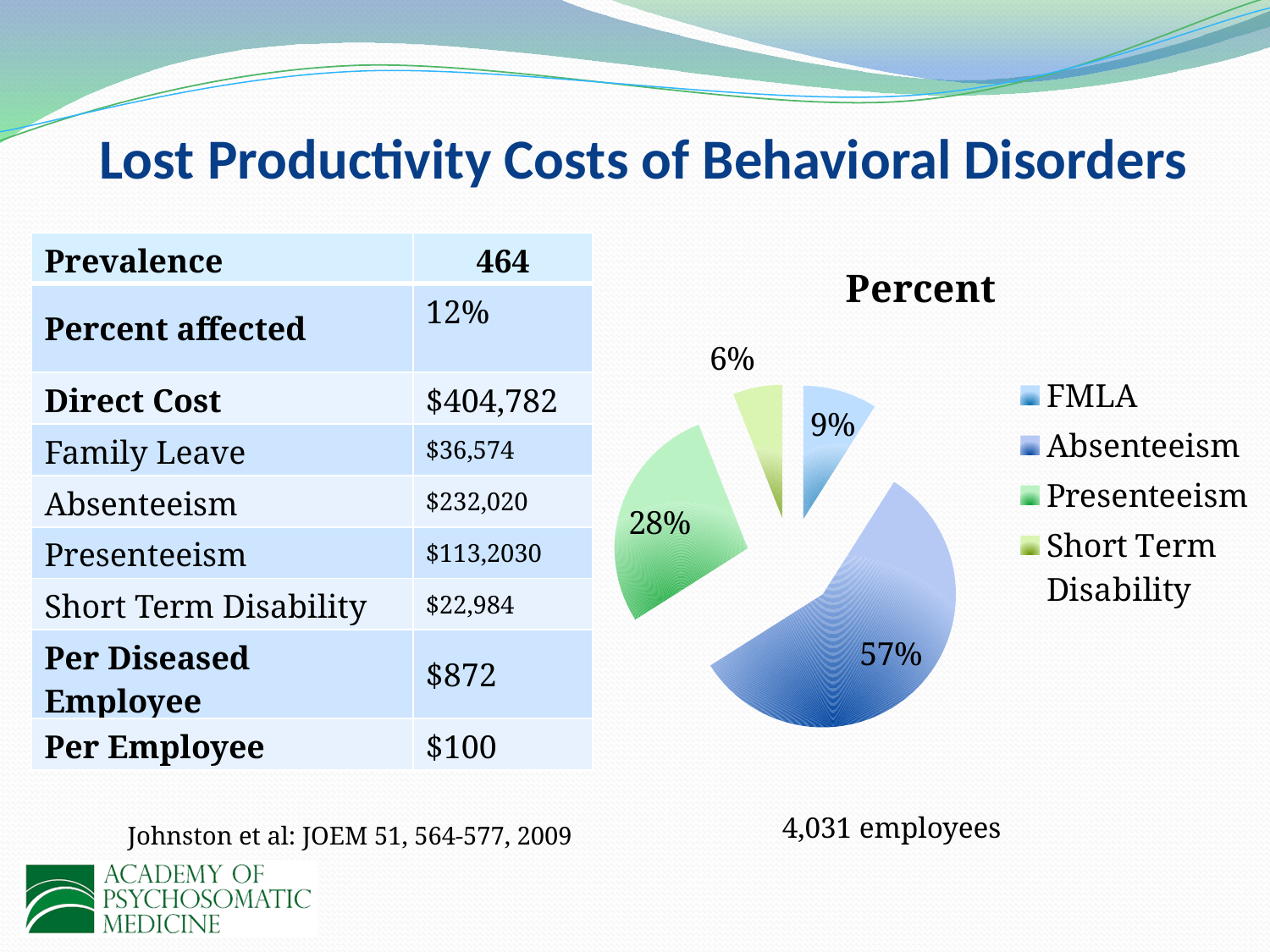
What percentage of the pie does Absenteeism account for? 57% What percentage of the pie does Presenteeism account for? 28% What percentage of the pie does FMLA account for? 9% Which category has the largest share of the pie? Absenteeism Is the share for Presenteeism greater or less than 50%? less What is the difference in percentage points between the Absenteeism and Presenteeism slices? 29 What is the title of the pie chart? Percent Which slice is larger, FMLA or Short Term Disability? FMLA Which category has the smallest share of the pie? Short Term Disability How many categories does the legend of the pie chart list? 4 What kind of chart is shown on the slide? pie chart What percentage of the pie does Short Term Disability account for? 6%